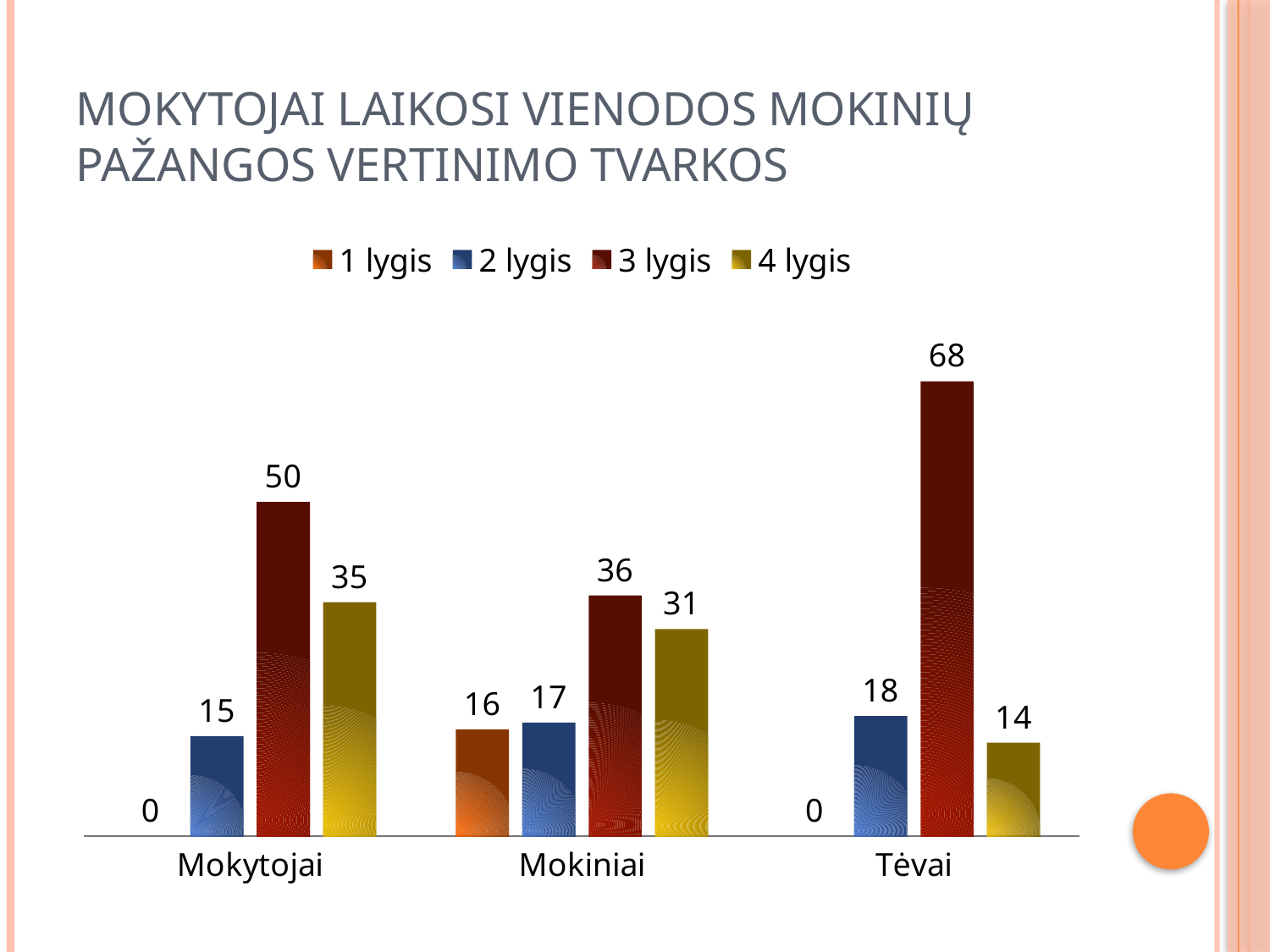
What is the value for 3 lygis in the Tėvai category? 68 What is the value for 4 lygis in the Mokiniai category? 31 What is the value for 2 lygis in the Mokytojai category? 15 What is the value for 1 lygis in the Tėvai category? 0 How many series does the legend list? 4 What is the value for 1 lygis in the Mokiniai category? 16 Which is larger: the 4 lygis value for Mokytojai or the 4 lygis value for Mokiniai? Mokytojai Which category has the highest value for 3 lygis? Tėvai What is the difference between the 3 lygis values for Tėvai and Mokytojai? 18 Which category has the lowest value for 4 lygis? Tėvai What kind of chart is shown on the slide? Bar chart How many categories are shown on the x axis? 3